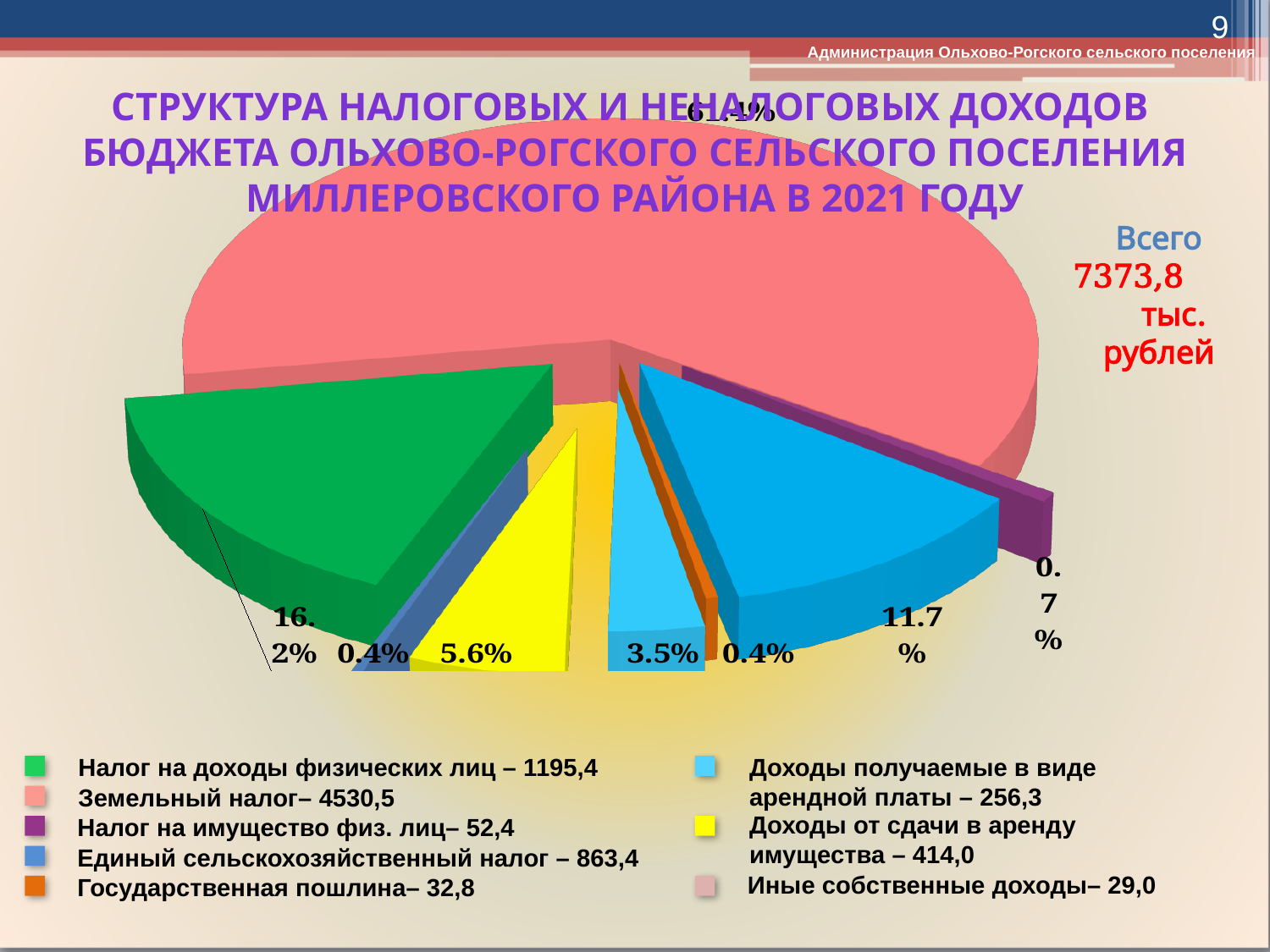
What is the value for Налог на доходы физических лиц in the legend? 1195,4 What kind of chart is shown on the slide? pie chart Which category has the largest value in the pie chart? Земельный налог Which is larger: Налог на доходы физических лиц or Единый сельскохозяйственный налог? Налог на доходы физических лиц What total amount (Всего) is shown next to the pie chart? 7373,8 тыс. рублей What is the value for Единый сельскохозяйственный налог in the legend? 863,4 What share of the pie does Налог на доходы физических лиц (green slice) represent? 16.2% Which category has the smallest value according to the legend? Иные собственные доходы How many categories does the legend of the pie chart list? 8 What share of the pie does Доходы от сдачи в аренду имущества (yellow slice) represent? 5.6% What is the difference between Налог на доходы физических лиц (1195,4) and Единый сельскохозяйственный налог (863,4)? 332,0 What is the value for Государственная пошлина in the legend? 32,8